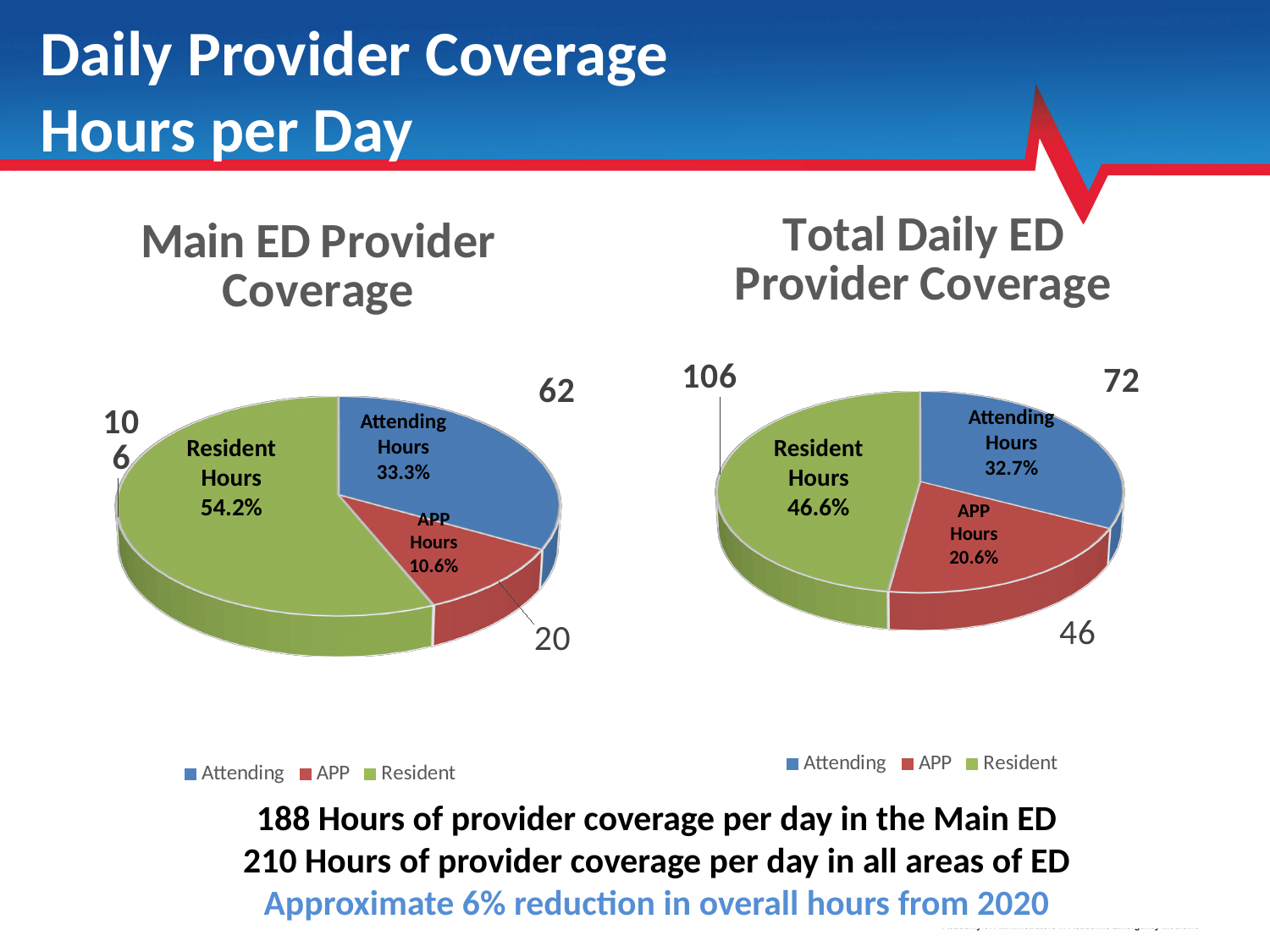
What type of chart is the Main ED Provider Coverage chart? Pie chart In the Main ED Provider Coverage chart, what percentage is shown for APP Hours? 10.6% In the Total Daily ED Provider Coverage chart, what value is labelled for the Resident slice? 106 In the Main ED Provider Coverage chart, which category has the smallest share? APP In the Main ED Provider Coverage chart, what percentage is shown for Attending Hours? 33.3% In the Total Daily ED Provider Coverage chart, what is the difference between the Attending value (72) and the APP value (46)? 26 How many categories does the legend of the Total Daily ED Provider Coverage chart list? 3 In the Total Daily ED Provider Coverage chart, which category has the largest share? Resident In the Main ED Provider Coverage chart, what value is labelled for the Attending slice? 62 In the Main ED Provider Coverage chart, what percentage is shown for Resident Hours? 54.2% In the Total Daily ED Provider Coverage chart, what percentage is shown for APP Hours? 20.6% In the Main ED Provider Coverage chart, which is larger, the Attending slice or the APP slice? Attending